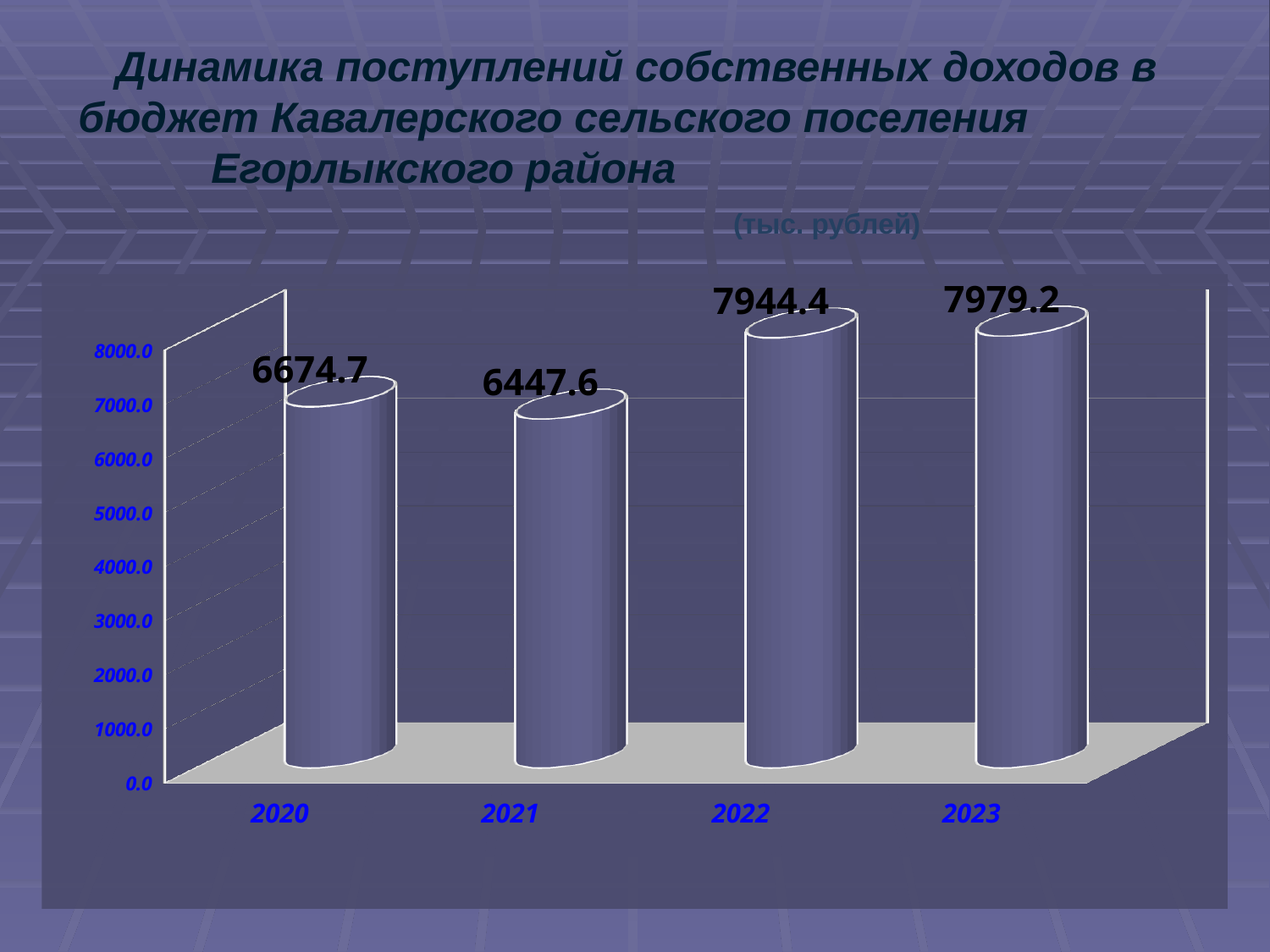
What is the value for 2022? 7944.4 What kind of chart is shown on the slide? bar chart Is the value for 2020 greater or less than 7000.0? less Which year has the highest value? 2023 Which is larger, the value for 2020 or the value for 2021? 2020 What is the value for 2021? 6447.6 What is the value for 2020? 6674.7 What is the difference between the values for 2023 and 2022? 34.8 What is the value for 2023? 7979.2 How many years are shown on the x axis? 4 Which year has the lowest value? 2021 What is the difference between the values for 2020 and 2021? 227.1